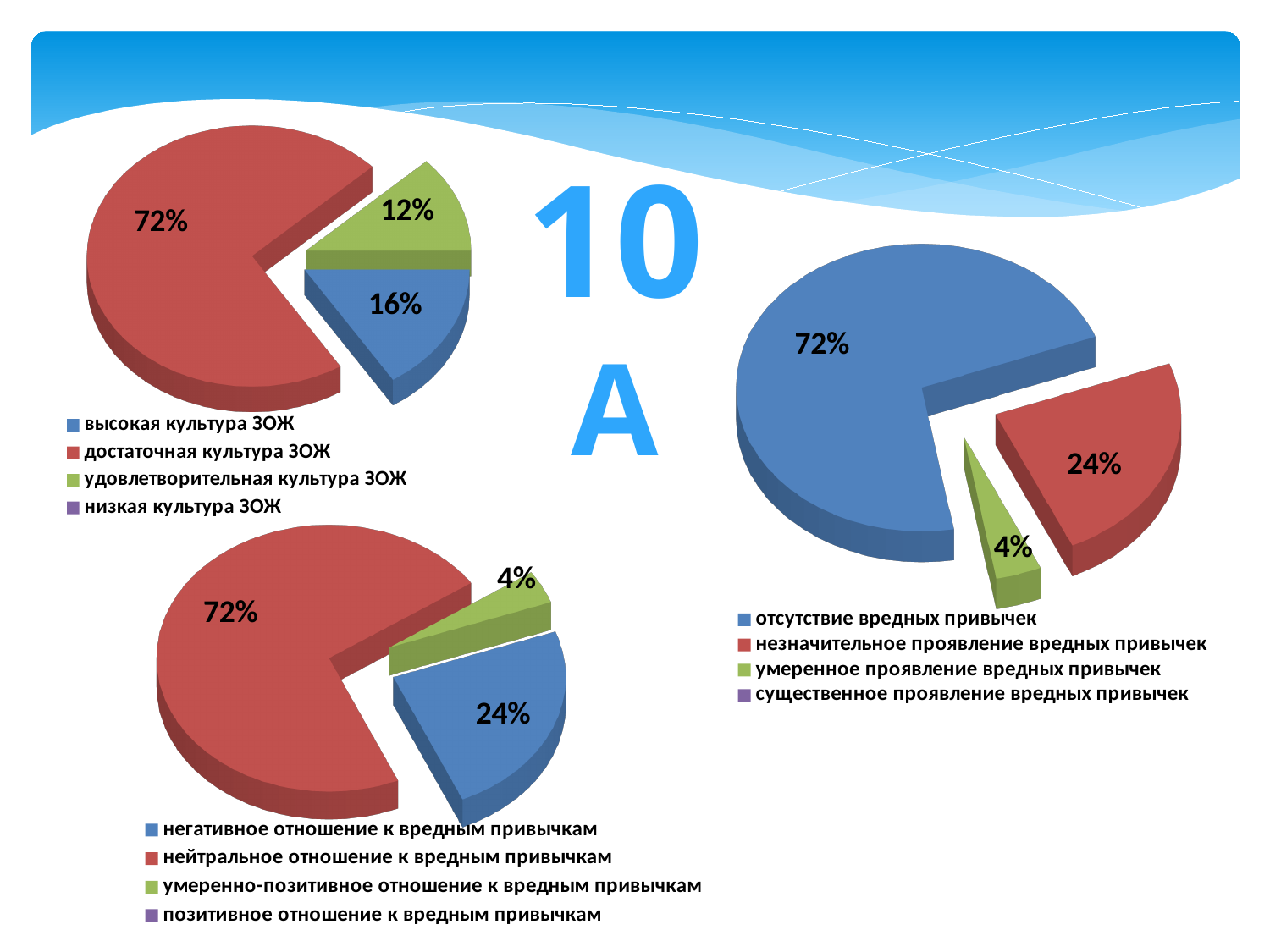
In the bottom-left pie chart, what share is labelled for 'умеренно-позитивное отношение к вредным привычкам'? 4% In the top-left pie chart, what share is labelled for 'удовлетворительная культура ЗОЖ'? 12% In the pie chart on the right, what share is labelled for 'незначительное проявление вредных привычек'? 24% In the top-left pie chart, what share is labelled for 'достаточная культура ЗОЖ'? 72% In the top-left pie chart, which category has the largest slice? достаточная культура ЗОЖ In the pie chart on the right, which category has the largest slice? отсутствие вредных привычек How many entries does the legend of the pie chart on the right list? 4 In the top-left pie chart, what is the difference between the shares for 'высокая культура ЗОЖ' and 'удовлетворительная культура ЗОЖ'? 4% In the top-left pie chart, what share is labelled for 'высокая культура ЗОЖ'? 16% In the bottom-left pie chart, what share is labelled for 'негативное отношение к вредным привычкам'? 24% In the pie chart on the right, which is larger: the share for 'незначительное проявление вредных привычек' or for 'умеренное проявление вредных привычек'? незначительное проявление вредных привычек In the bottom-left pie chart, which category has the largest slice? нейтральное отношение к вредным привычкам